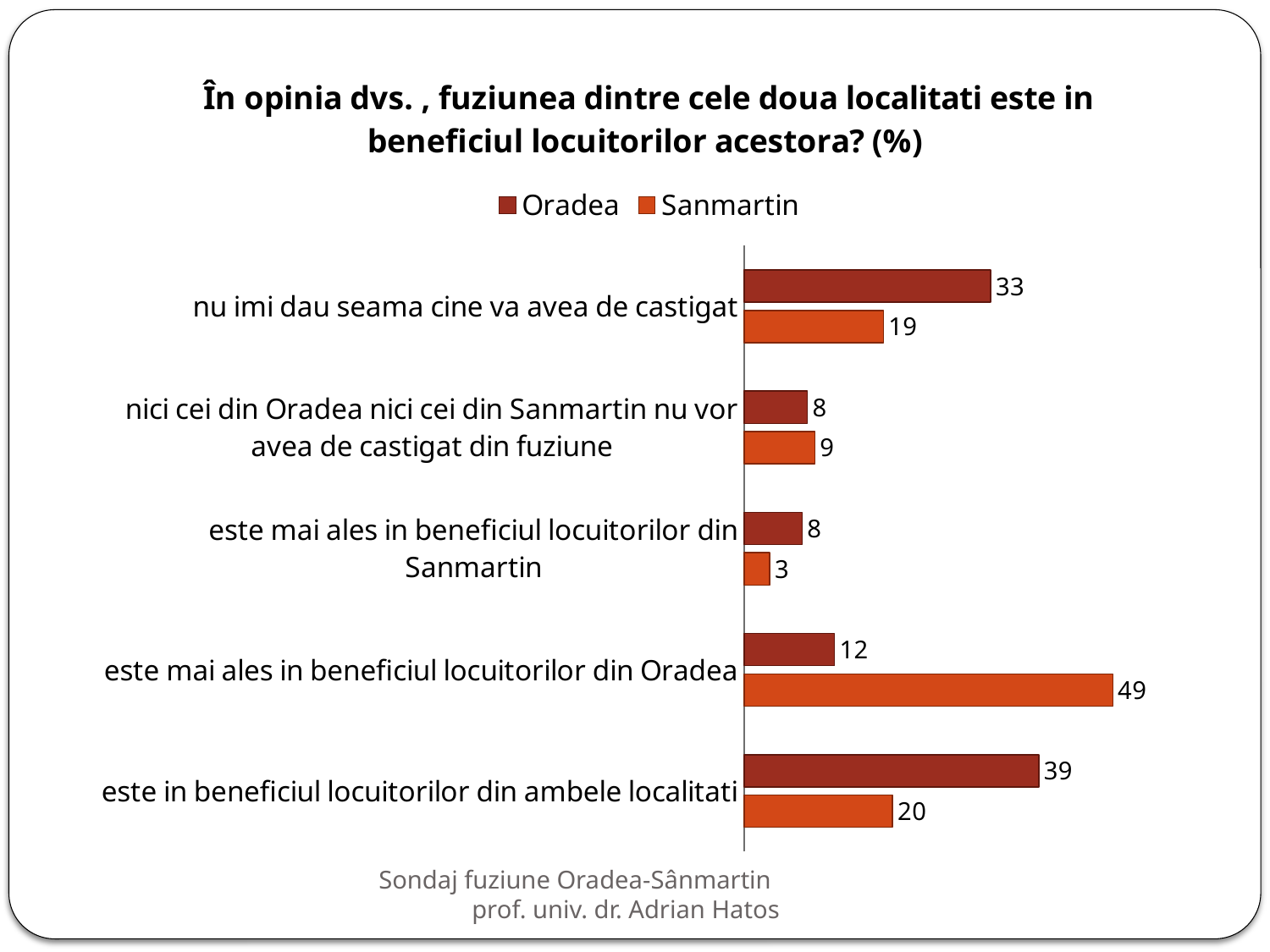
For "nu imi dau seama cine va avea de castigat", which is larger, the Oradea value or the Sanmartin value? Oradea What is the difference between the Sanmartin and Oradea values for "este mai ales in beneficiul locuitorilor din Oradea"? 37 What is the Sanmartin value for "este mai ales in beneficiul locuitorilor din Oradea"? 49 What kind of chart is shown on the slide? bar chart What is the Sanmartin value for "nu imi dau seama cine va avea de castigat"? 19 How many categories are shown on the chart? 5 How many series does the legend list? 2 Which category has the highest Oradea value? este in beneficiul locuitorilor din ambele localitati What is the Oradea value for "este in beneficiul locuitorilor din ambele localitati"? 39 Which category has the highest Sanmartin value? este mai ales in beneficiul locuitorilor din Oradea Which category has the lowest Sanmartin value? este mai ales in beneficiul locuitorilor din Sanmartin What is the Oradea value for "este mai ales in beneficiul locuitorilor din Sanmartin"? 8